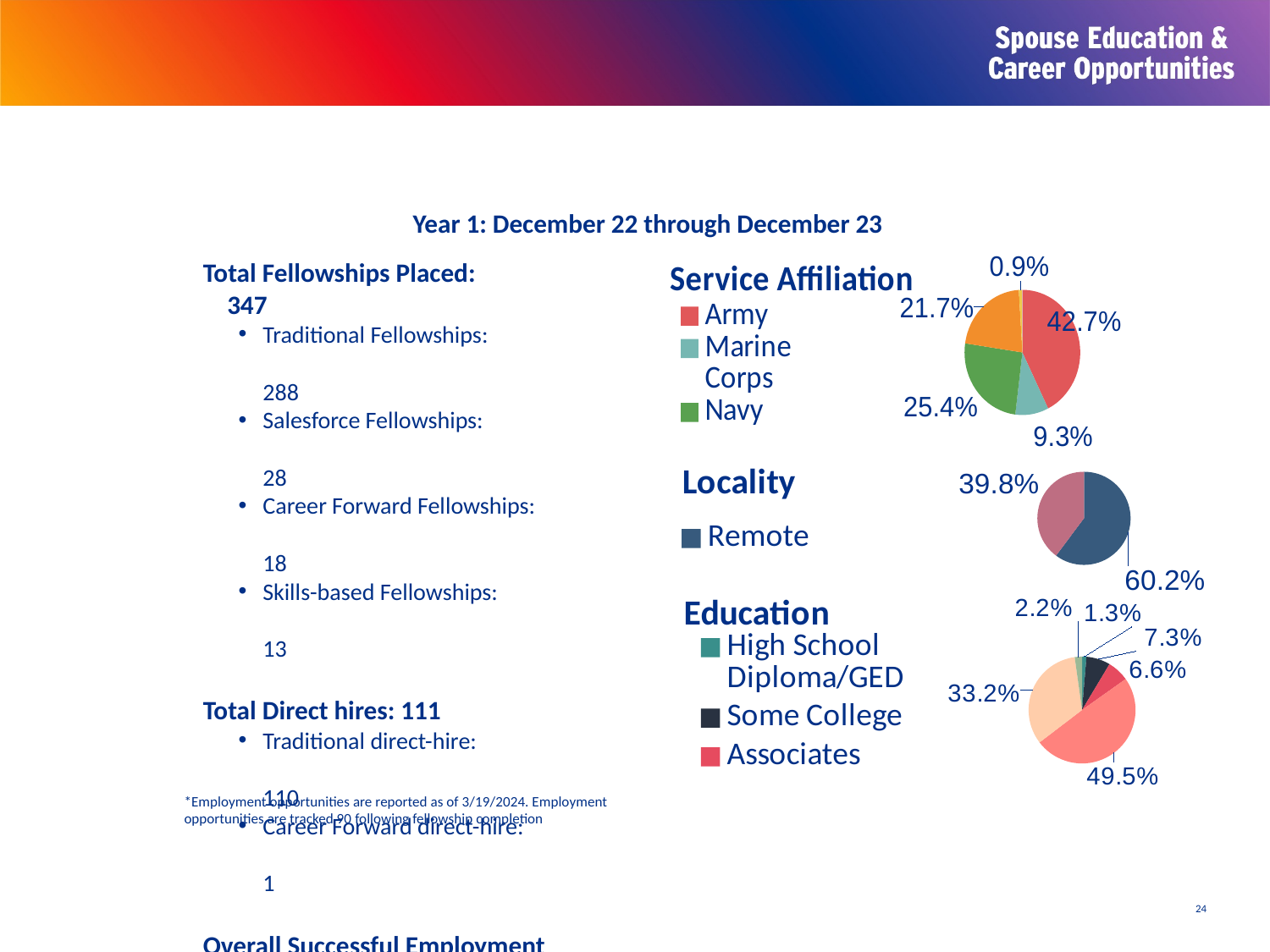
What is the largest percentage shown on the Education chart? 49.5% On the Service Affiliation chart, what percentage is Navy? 25.4% On the Education chart, what percentage is Associates? 6.6% On the Service Affiliation chart, what percentage is Army? 42.7% What kind of chart is used for Service Affiliation? pie chart On the Service Affiliation chart, what percentage is Marine Corps? 9.3% On the Service Affiliation chart, what is the difference in percentage points between Army and Navy? 17.3 On the Service Affiliation chart, which of Army or Navy has the larger share? Army On the Education chart, what percentage is Some College? 7.3% How many slices does the Service Affiliation pie chart have? 5 On the Locality chart, is the value for Remote greater or less than 50%? greater On the Locality chart, what percentage is Remote? 60.2%